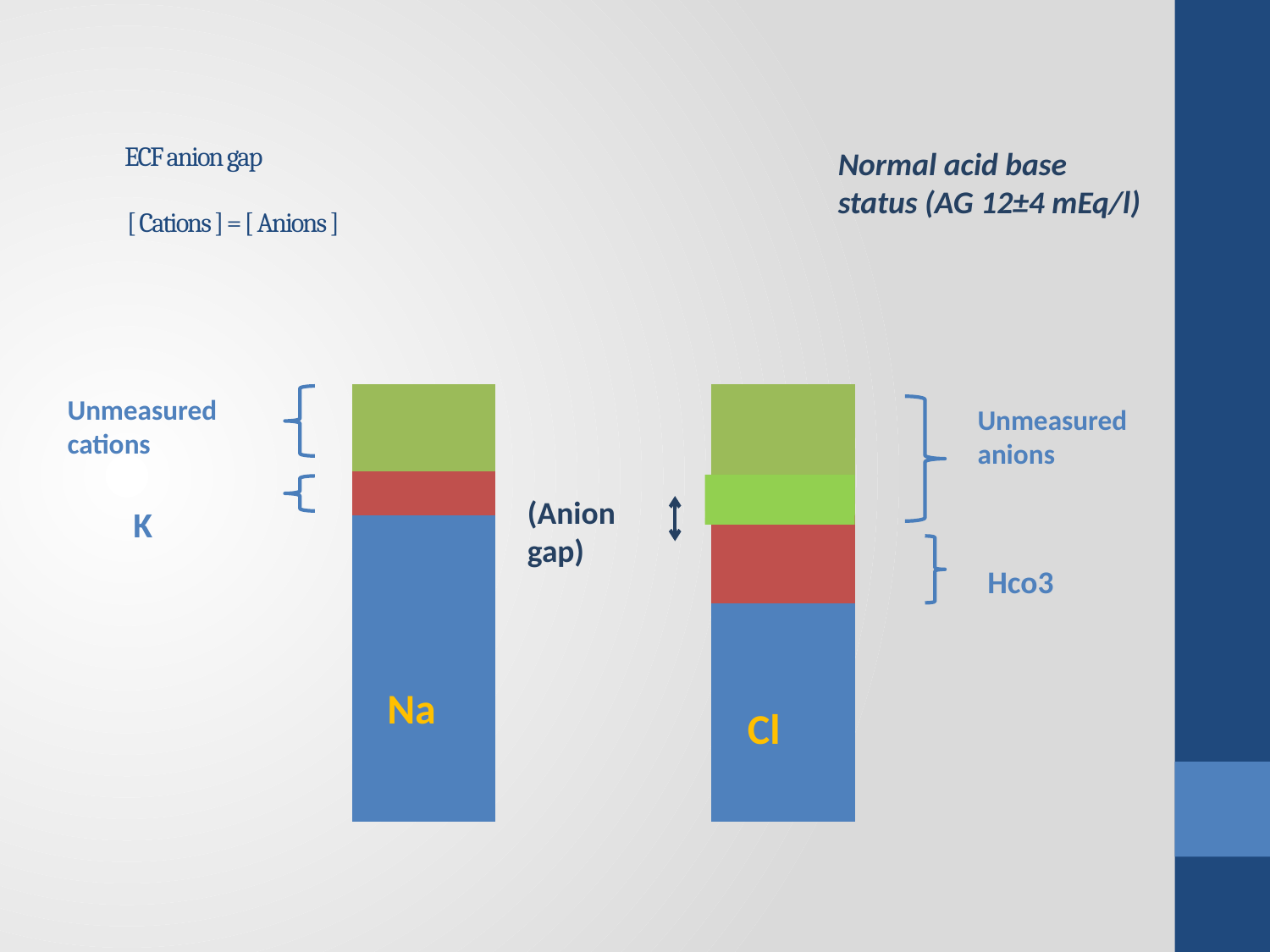
Which segment is the smallest in the left (cations) bar? K What does the double-headed arrow between the two bars represent? Anion gap In the right bar, which is larger, the Unmeasured anions segment or the Hco3 segment? Unmeasured anions Which segment is the largest in the right (anions) bar? Cl What kind of chart is shown on the slide? stacked bar chart What normal anion gap value is stated in the slide's heading? 12±4 mEq/l In the right bar, which is larger, the Cl segment or the Hco3 segment? Cl In the left bar, which is larger, the Unmeasured cations segment or the K segment? Unmeasured cations How many bars are shown in the diagram? 2 Which segment is the largest in the left (cations) bar? Na What label is written inside the blue segment of the right bar? Cl